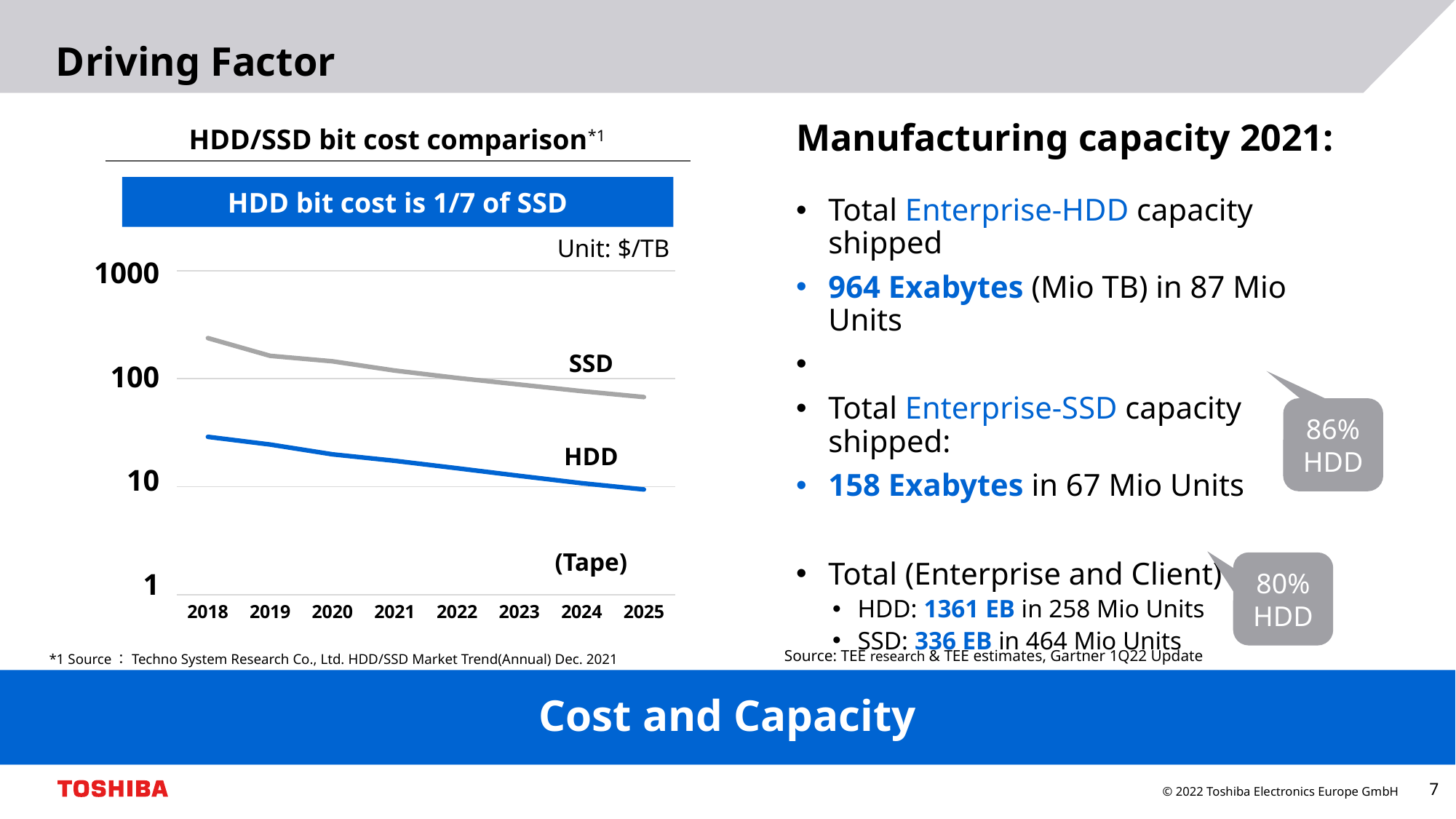
In the HDD/SSD bit cost comparison chart, is the HDD value for 2018 greater or less than 10? greater In the HDD/SSD bit cost comparison chart, is the SSD value for 2025 greater or less than 100? less What does the blue banner above the HDD/SSD bit cost comparison chart say? HDD bit cost is 1/7 of SSD In the HDD/SSD bit cost comparison chart, does the SSD line rise or fall from 2018 to 2025? fall In the HDD/SSD bit cost comparison chart, which series has the higher bit cost in 2021, SSD or HDD? SSD In the HDD/SSD bit cost comparison chart, does the HDD line rise or fall from 2018 to 2025? fall In the HDD/SSD bit cost comparison chart, is the HDD value for 2025 greater or less than 100? less What unit is used for the values in the HDD/SSD bit cost comparison chart? $/TB How many years are shown on the x axis of the HDD/SSD bit cost comparison chart? 8 How many data series are plotted as lines in the HDD/SSD bit cost comparison chart? 2 What kind of chart is the HDD/SSD bit cost comparison? line chart